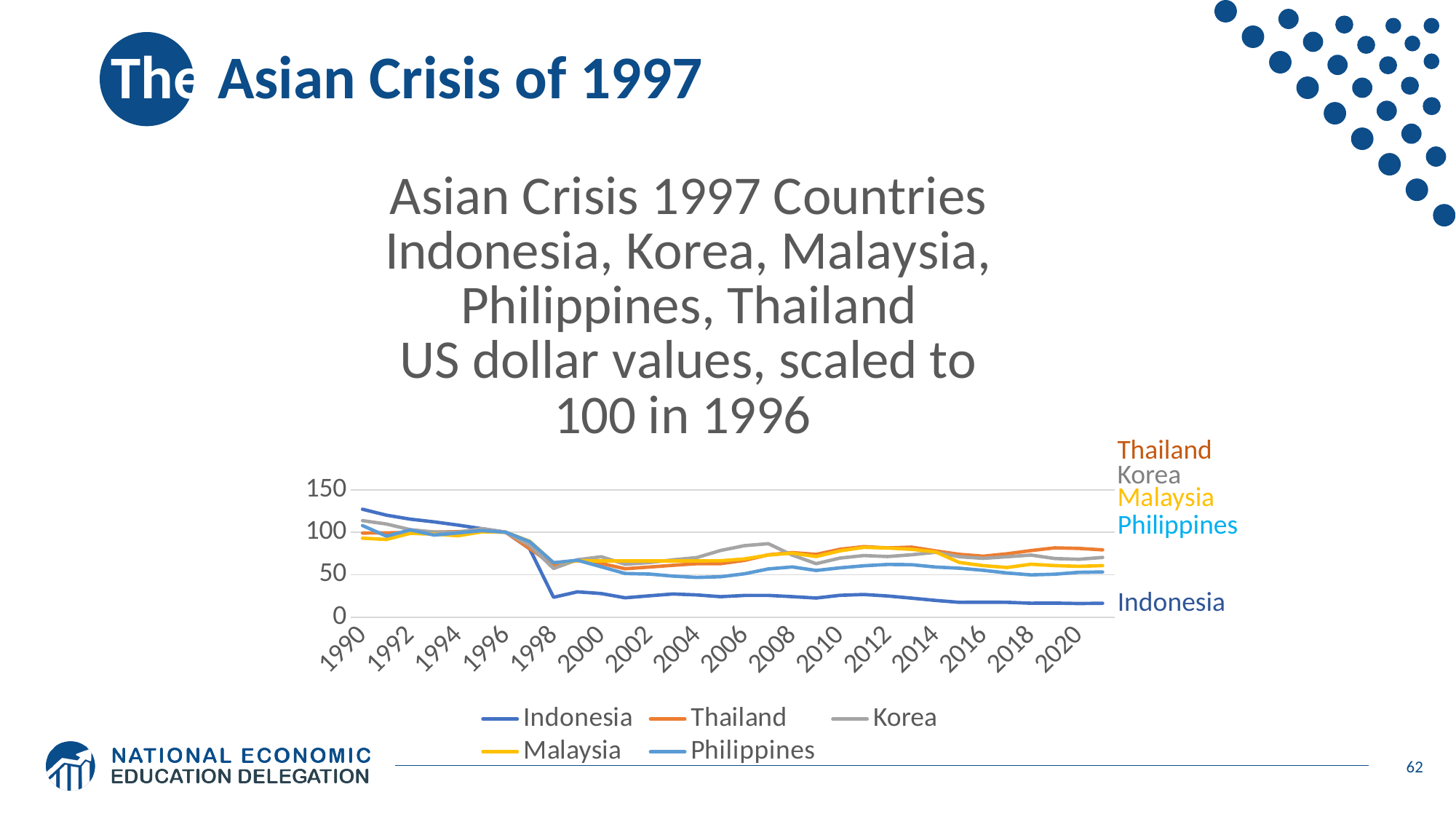
How many series does the chart legend list? 5 Which country has the lowest value in 2020? Indonesia What is the value for Indonesia in 1996? 100 In which year are all the series scaled to 100? 1996 Which countries are listed in the chart legend? Indonesia, Thailand, Korea, Malaysia, Philippines Which is larger in 2020, the value for Thailand or the value for Indonesia? Thailand Is the value for Thailand in 2020 greater or less than 50? greater Does the value for Indonesia rise or fall from 1996 to 2020? fall Is the value for Indonesia in 2020 greater or less than 50? less What kind of chart is shown on the slide? line chart Which country has the highest value in 1990? Indonesia Is the value for Indonesia in 1990 greater or less than 100? greater